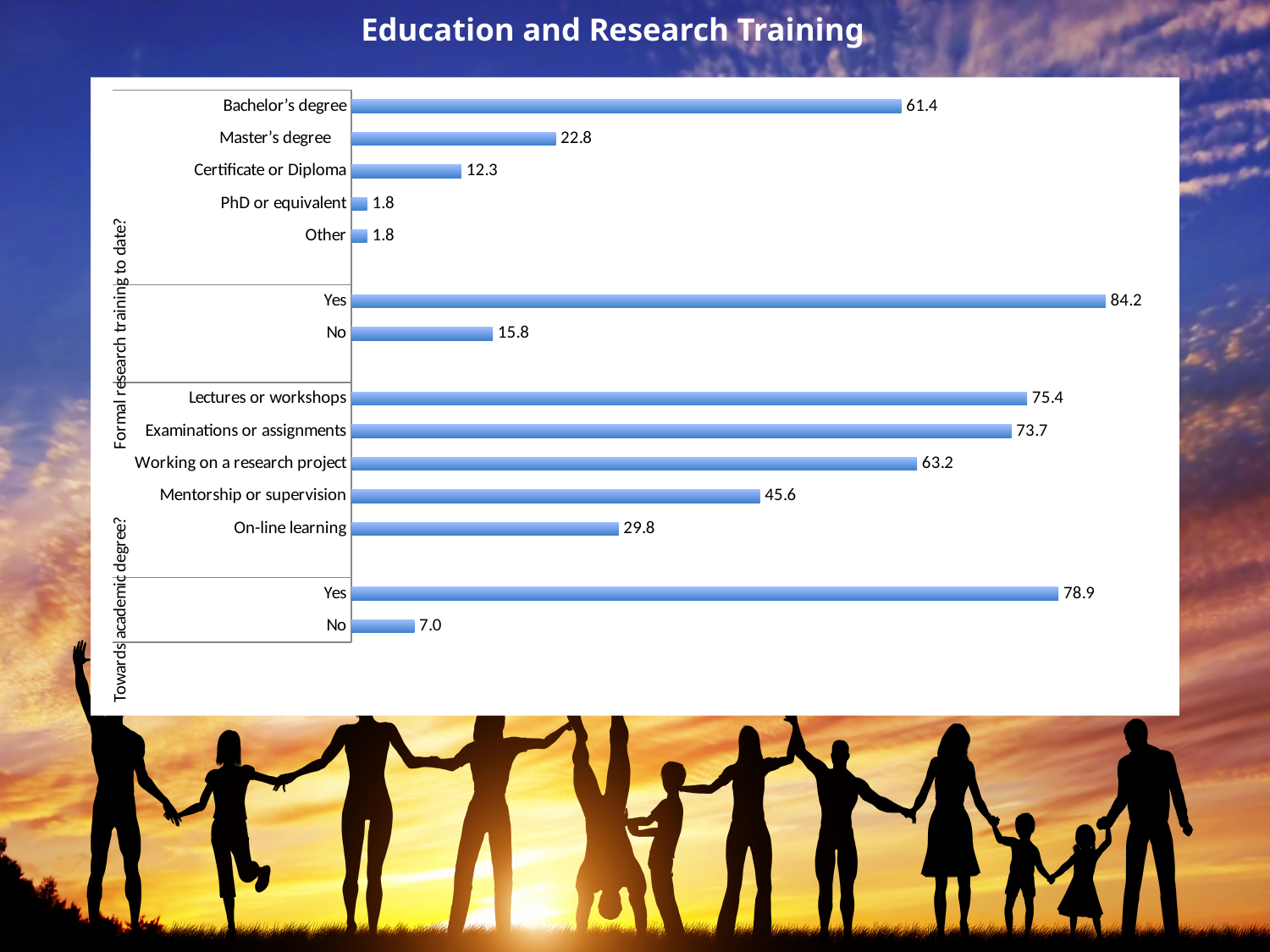
How many bars are plotted in the chart? 14 Among Lectures or workshops, Examinations or assignments, Working on a research project, Mentorship or supervision and On-line learning, which has the lowest value? On-line learning What is the value for the 'No' bar at the bottom of the chart (the last bar)? 7.0 What is the difference between the values for Lectures or workshops and Examinations or assignments? 1.7 What is the value for Mentorship or supervision? 45.6 Which is larger, the value for Working on a research project or the value for Bachelor's degree? Working on a research project Which bar has the highest value in the chart? Yes (84.2) What is the value for Bachelor's degree? 61.4 What is the difference between the values for Bachelor's degree and Master's degree? 38.6 What kind of chart is shown on the slide? bar chart What is the title of the slide? Education and Research Training What is the value for Certificate or Diploma? 12.3